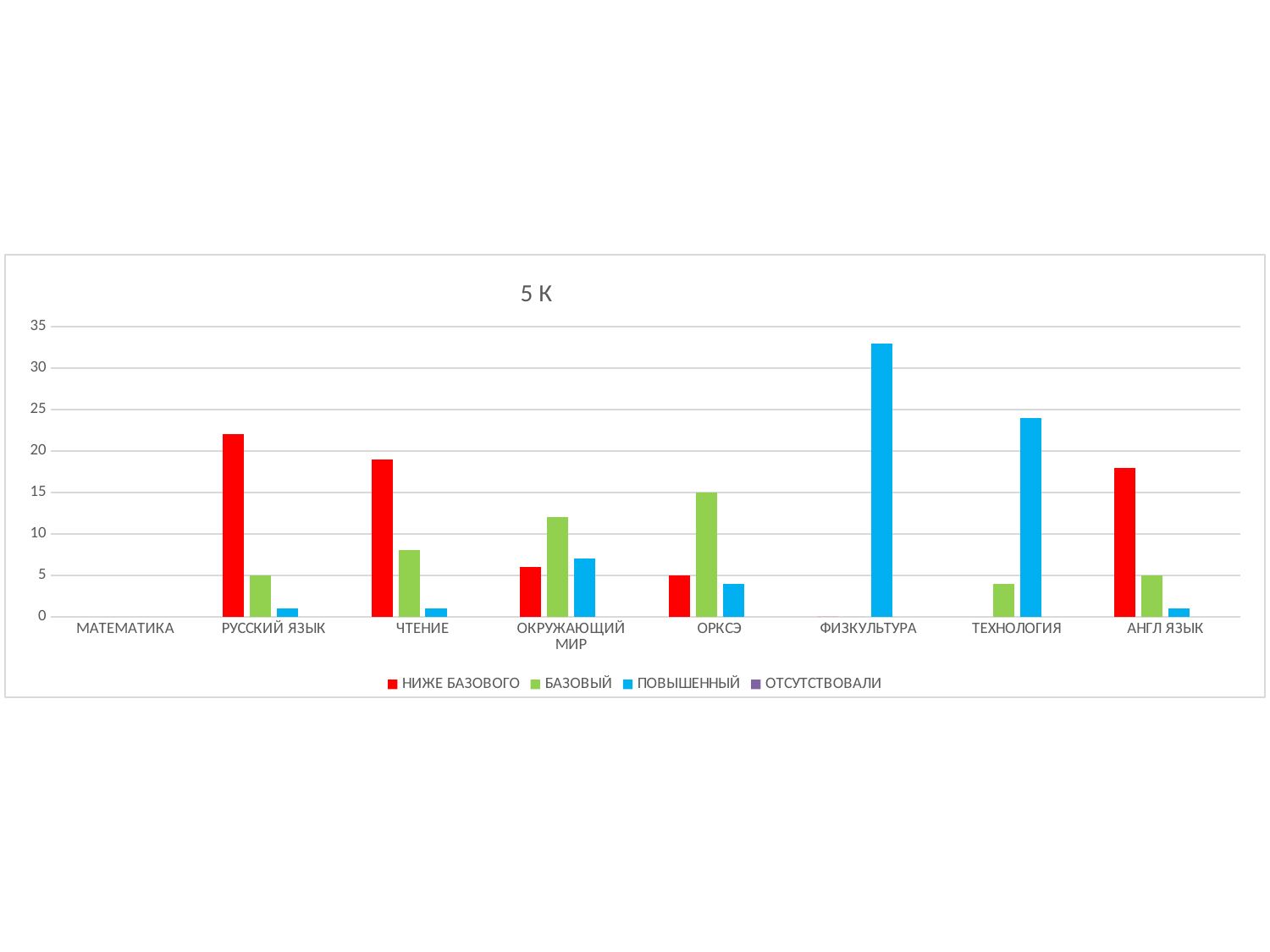
Which category has the highest БАЗОВЫЙ bar? ОРКСЭ Which category has the highest ПОВЫШЕННЫЙ bar? ФИЗКУЛЬТУРА What is the title of the chart? 5 К Is the НИЖЕ БАЗОВОГО value for РУССКИЙ ЯЗЫК greater or less than 20? greater Which is larger for ЧТЕНИЕ: the НИЖЕ БАЗОВОГО bar or the БАЗОВЫЙ bar? НИЖЕ БАЗОВОГО What type of chart is shown on the slide? bar chart Which is larger for ОКРУЖАЮЩИЙ МИР: the БАЗОВЫЙ bar or the ПОВЫШЕННЫЙ bar? БАЗОВЫЙ Is the ПОВЫШЕННЫЙ value for ФИЗКУЛЬТУРА greater or less than 30? greater Is the ПОВЫШЕННЫЙ value for ТЕХНОЛОГИЯ greater or less than 20? greater How many categories are shown on the x axis? 8 How many series does the legend list? 4 Which category has the highest НИЖЕ БАЗОВОГО bar? РУССКИЙ ЯЗЫК